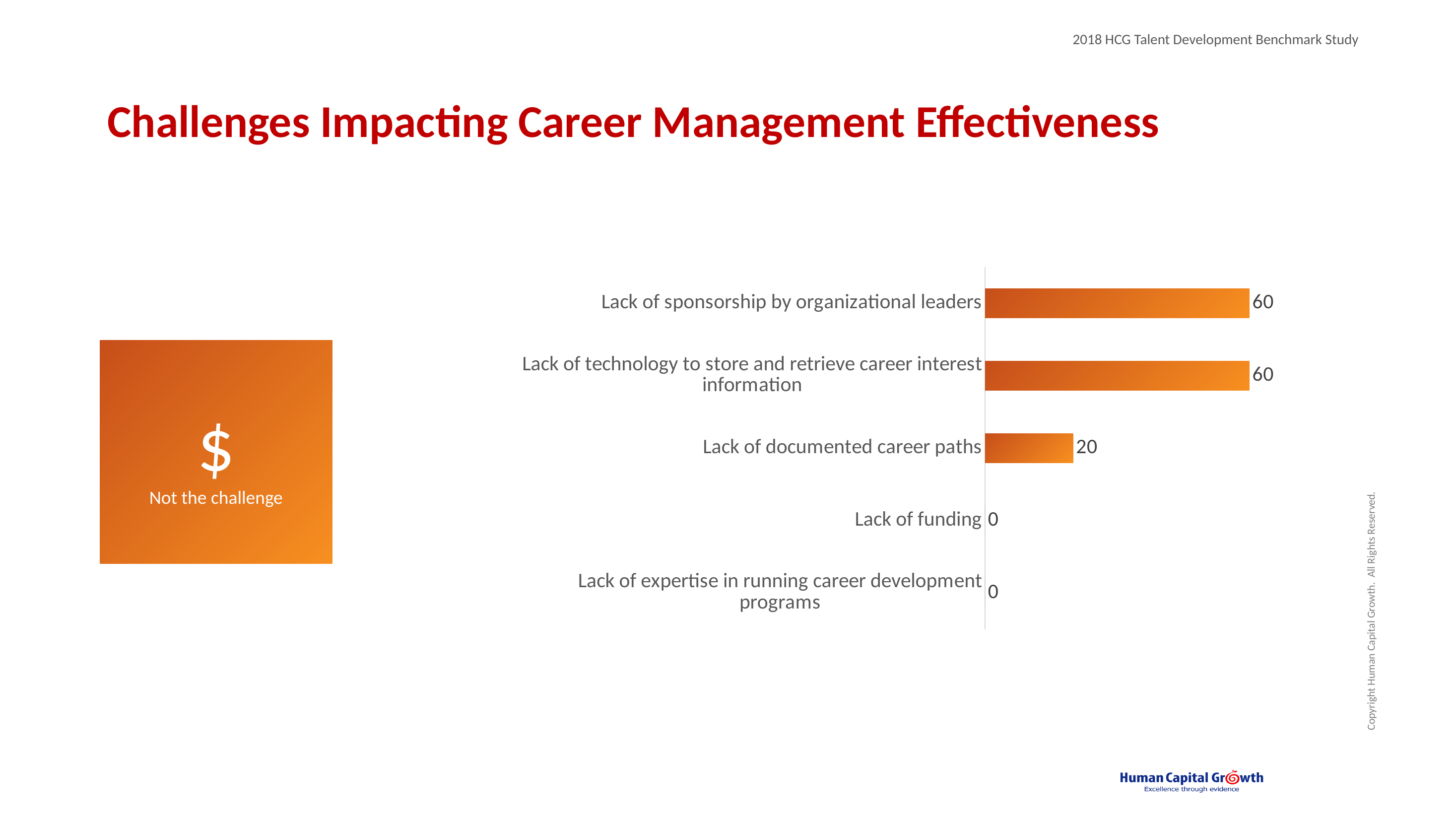
What is the title of the slide? Challenges Impacting Career Management Effectiveness What is the value for Lack of sponsorship by organizational leaders? 60 What is the value for Lack of technology to store and retrieve career interest information? 60 What is the value for Lack of expertise in running career development programs? 0 How many categories have a value of 0? 2 Which is larger, the value for Lack of documented career paths or the value for Lack of funding? Lack of documented career paths What is the difference between the values for Lack of sponsorship by organizational leaders and Lack of documented career paths? 40 Which is larger, the value for Lack of technology to store and retrieve career interest information or the value for Lack of documented career paths? Lack of technology to store and retrieve career interest information What kind of chart is shown on the slide? Bar chart What is the value for Lack of documented career paths? 20 What is the value for Lack of funding? 0 How many categories are shown in the chart? 5